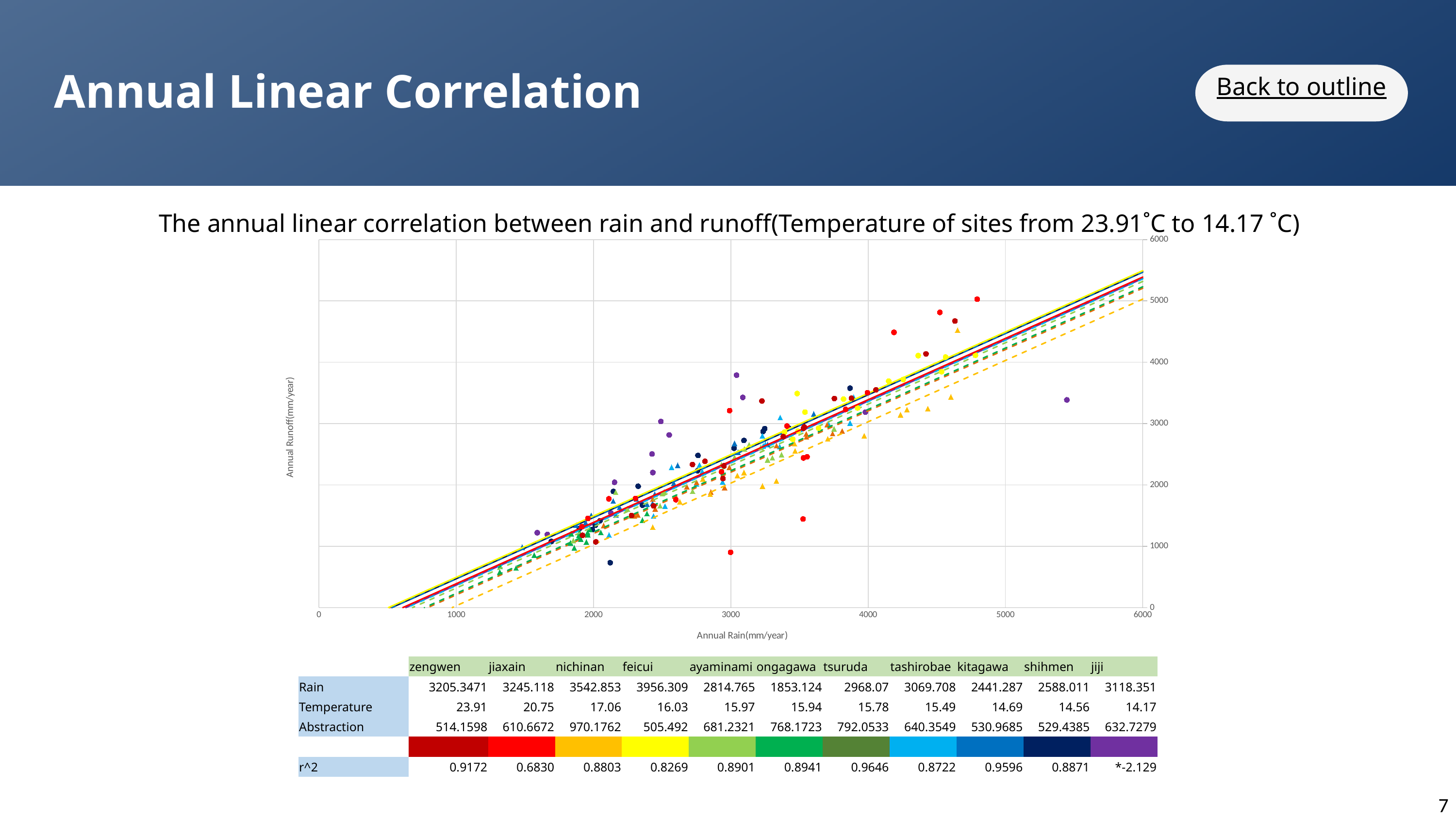
Which site has the highest Abstraction value in the table below the chart? nichinan How many sites are listed in the table below the chart? 11 What kind of chart is shown on the slide? Scatter chart What is the title of the chart's y axis? Annual Runoff(mm/year) What is the difference between the Temperature values of zengwen and jiji in the table below the chart? 9.74 Which site has a higher Temperature in the table below the chart, jiaxain or nichinan? jiaxain What is the title of the chart's x axis? Annual Rain(mm/year) What is the r^2 value for tsuruda in the table below the chart? 0.9646 Which site has the highest Rain value in the table below the chart? feicui What is the Temperature value for zengwen in the table below the chart? 23.91 Which site has the lowest Rain value in the table below the chart? ongagawa What is the Rain value for feicui in the table below the chart? 3956.309